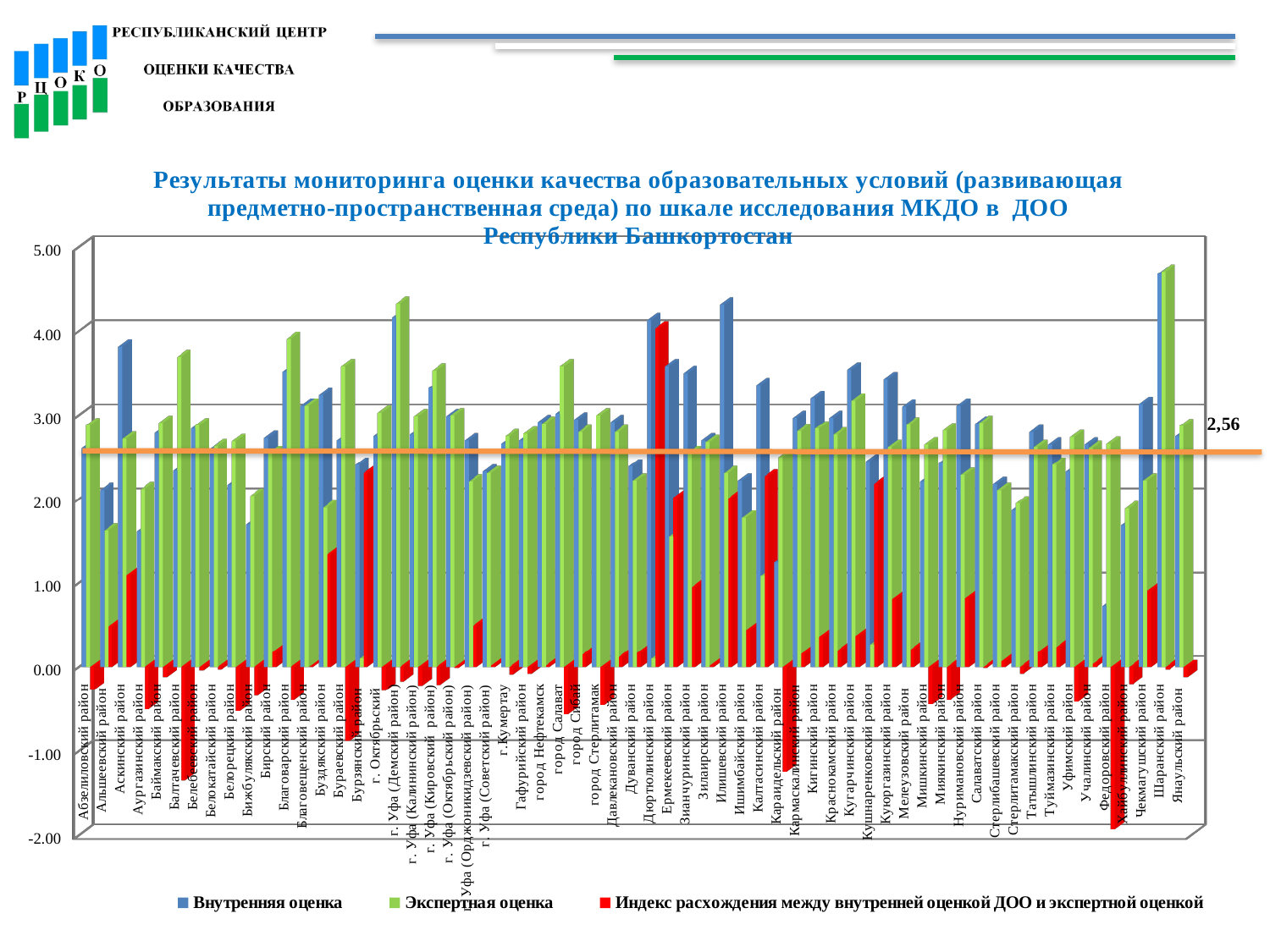
Which district has the highest Индекс расхождения value? Дюртюлинский район Which district has the highest Экспертная оценка value? Шаранский район Is the Индекс расхождения value for Федоровский район greater or less than -1.00? less Is the Внутренняя оценка value for Ермекеевский район greater or less than 2.00? greater What kind of chart is shown on the slide? bar chart What value is labelled on the horizontal reference line drawn across the chart? 2,56 Is the Внутренняя оценка value for Аскинский район greater or less than 3.00? greater How many series does the legend list? 3 Which is larger for Дюртюлинский район: the Внутренняя оценка or the Экспертная оценка? Внутренняя оценка Which series is shown in red according to the legend? Индекс расхождения между внутренней оценкой ДОО и экспертной оценкой